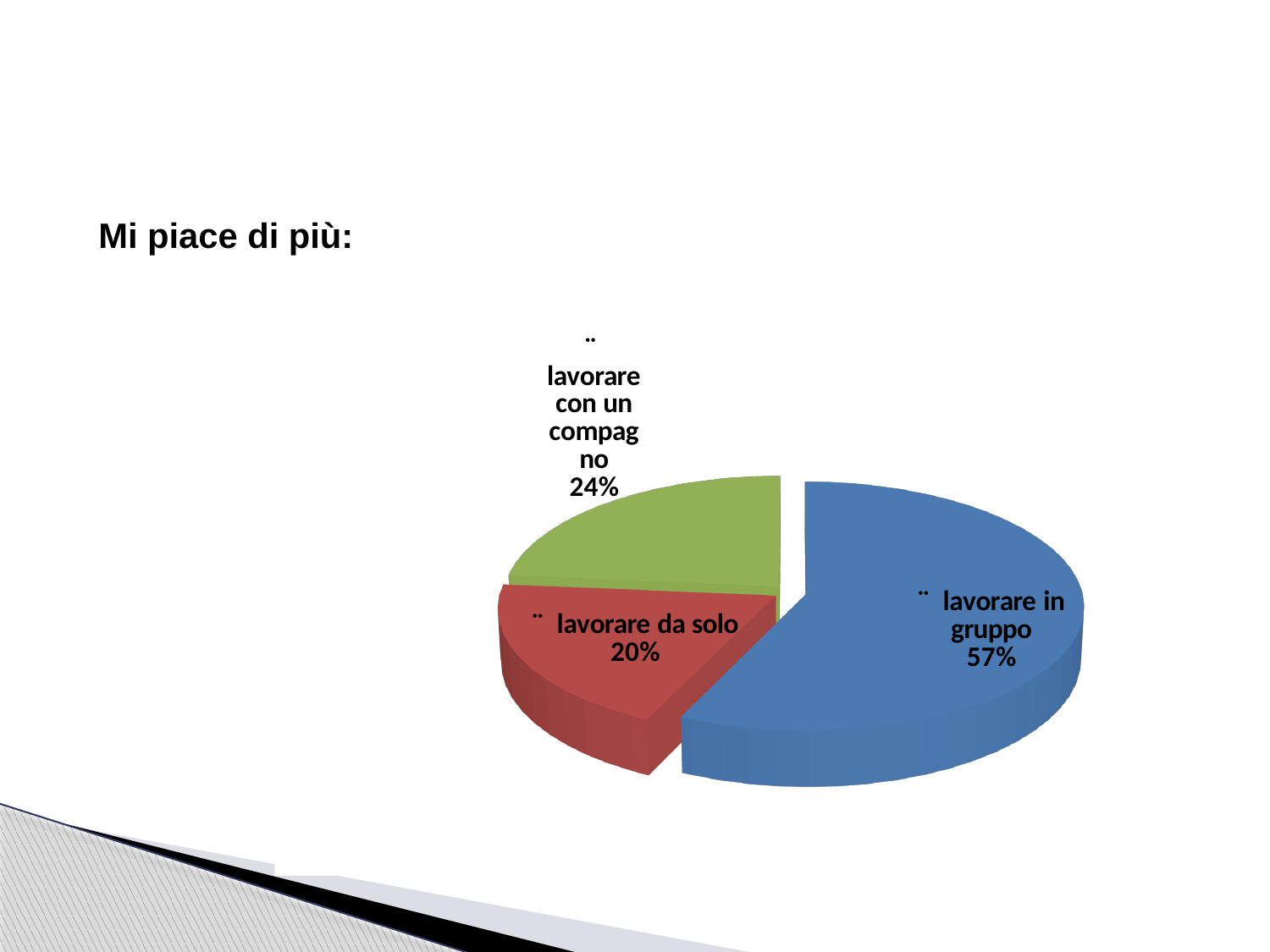
What percentage of the pie is 'lavorare con un compagno'? 24% What is the difference in percentage points between 'lavorare con un compagno' and 'lavorare da solo'? 4 What kind of chart is shown on the slide? pie chart Which slice of the pie is the largest? lavorare in gruppo How many slices does the pie chart have? 3 Which is larger, the share for 'lavorare con un compagno' or the share for 'lavorare da solo'? lavorare con un compagno What percentage of the pie is 'lavorare in gruppo'? 57% What is the difference in percentage points between 'lavorare in gruppo' and 'lavorare da solo'? 37 Which slice of the pie is the smallest? lavorare da solo What colour is the 'lavorare in gruppo' slice? blue What percentage of the pie is 'lavorare da solo'? 20% What is the text heading above the pie chart? Mi piace di più: